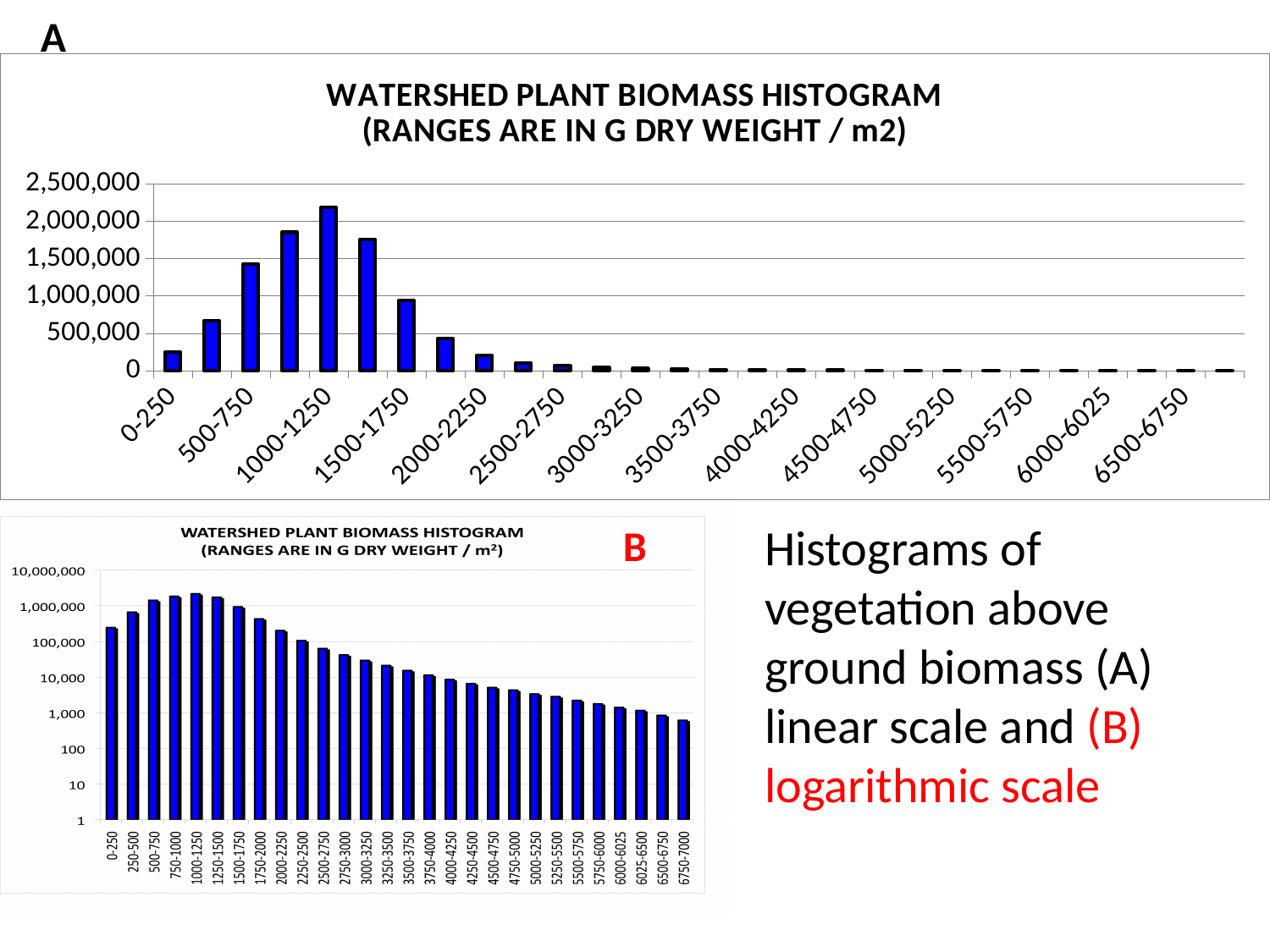
In chart A (the top chart), is the value for the 500-750 range greater or less than 1,000,000? greater In chart A (the top chart), which is larger, the value for 1000-1250 or the value for 2000-2250? 1000-1250 In chart A (the top chart), is the value for the 0-250 range greater or less than 500,000? less In chart B (the bottom-left chart), do the values rise or fall along the x axis after the 1000-1250 range? fall In chart A (the top chart), is the value for the 1000-1250 range greater or less than 2,000,000? greater In chart A (the top chart), which biomass range has the highest value? 1000-1250 How many biomass range categories are plotted in chart B (the bottom-left chart)? 28 What kind of chart is chart A (the top chart)? bar chart In chart B (the bottom-left chart), which biomass range has the lowest value? 6750-7000